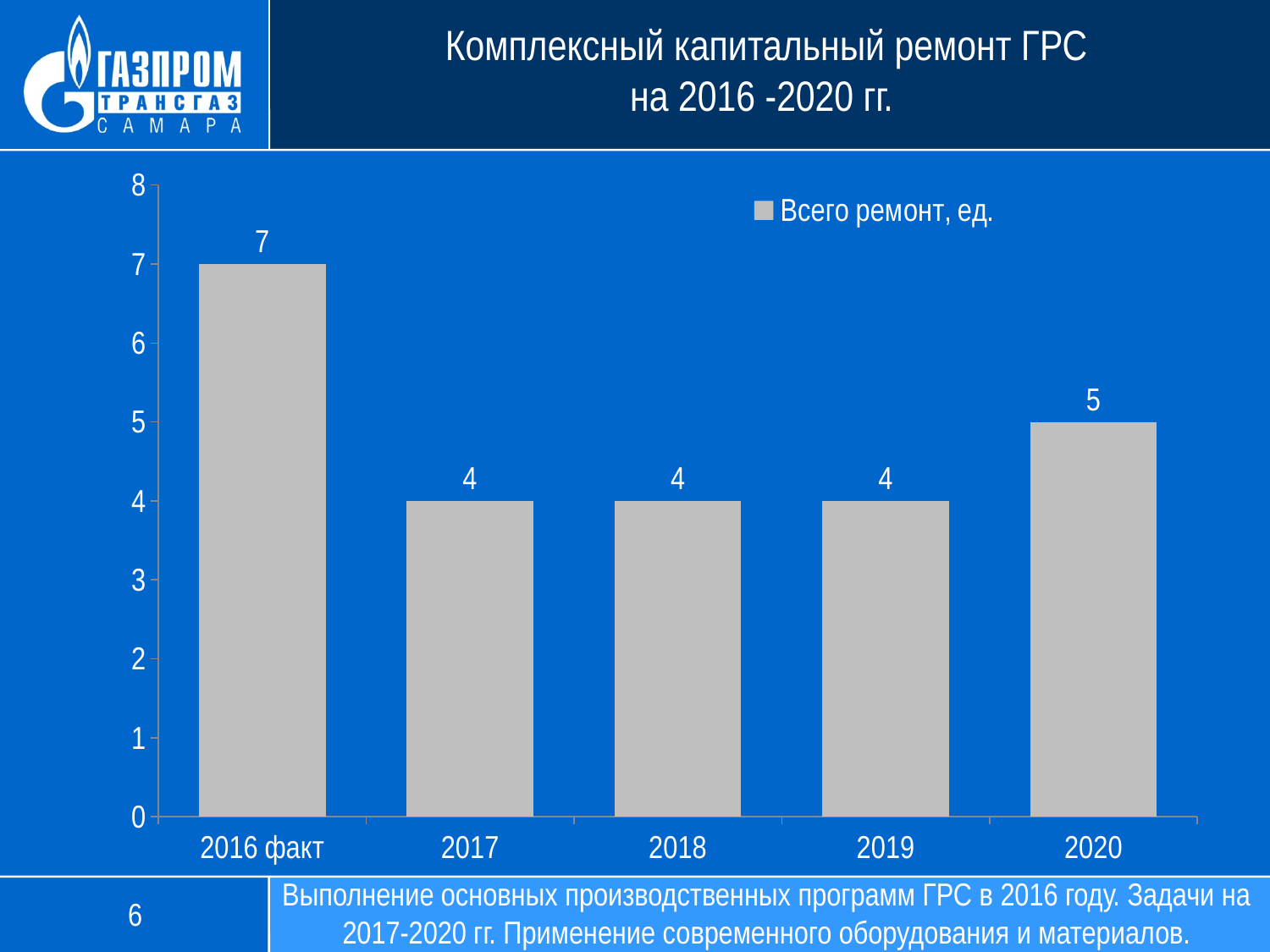
What is the value for 2018? 4 What is the difference between the values for 2020 and 2019? 1 What kind of chart is shown on the slide? bar chart What is the value for 2016 факт? 7 Which is larger, the value for 2017 or the value for 2020? 2020 What is the value for 2020? 5 What is the difference between the values for 2016 факт and 2020? 2 Which category has the highest value? 2016 факт How many series does the legend list? 1 How many categories are shown on the x axis? 5 What is the legend entry for the series shown? Всего ремонт, ед. Is the value for 2016 факт greater or less than 6? greater